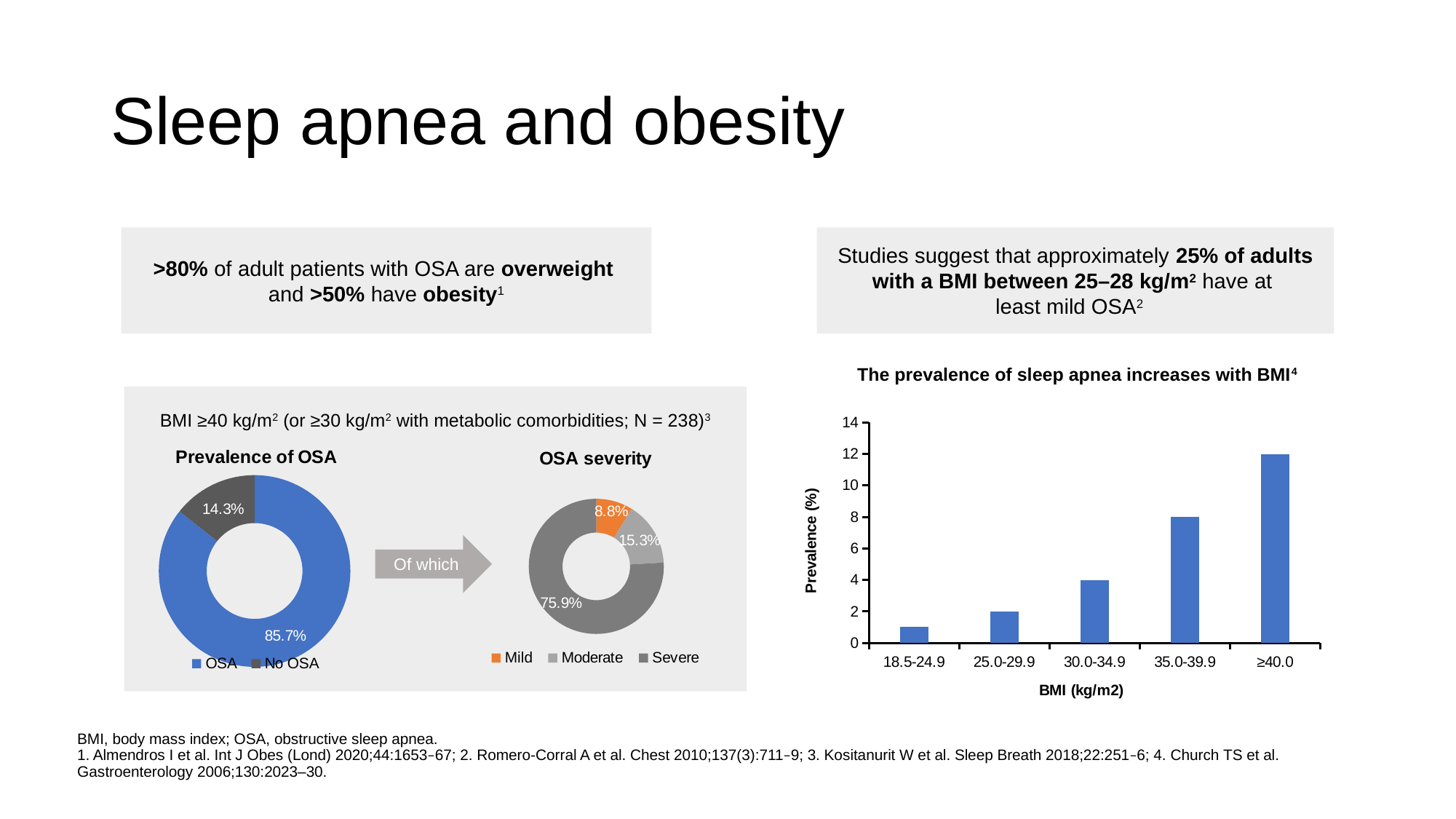
In the chart 'The prevalence of sleep apnea increases with BMI', what is the prevalence for the ≥40.0 BMI category? 12 In the 'OSA severity' donut chart, which severity category has the smallest share? Mild How many categories does the legend of the 'OSA severity' donut chart list? 3 In the chart 'The prevalence of sleep apnea increases with BMI', do the values rise or fall as BMI increases along the x axis? rise In the 'OSA severity' donut chart, what percentage is labelled Mild? 8.8% In the chart 'The prevalence of sleep apnea increases with BMI', is the value for 18.5-24.9 greater or less than 2? less In the 'Prevalence of OSA' donut chart, what percentage of patients have OSA? 85.7% In the 'OSA severity' donut chart, what is the difference between the Moderate and Mild shares? 6.5% In the 'OSA severity' donut chart, what percentage is labelled Severe? 75.9% In the chart 'The prevalence of sleep apnea increases with BMI', how many BMI categories are shown on the x axis? 5 In the chart 'The prevalence of sleep apnea increases with BMI', what is the prevalence for the 35.0-39.9 BMI category? 8 In the 'Prevalence of OSA' donut chart, what percentage of patients have no OSA? 14.3%